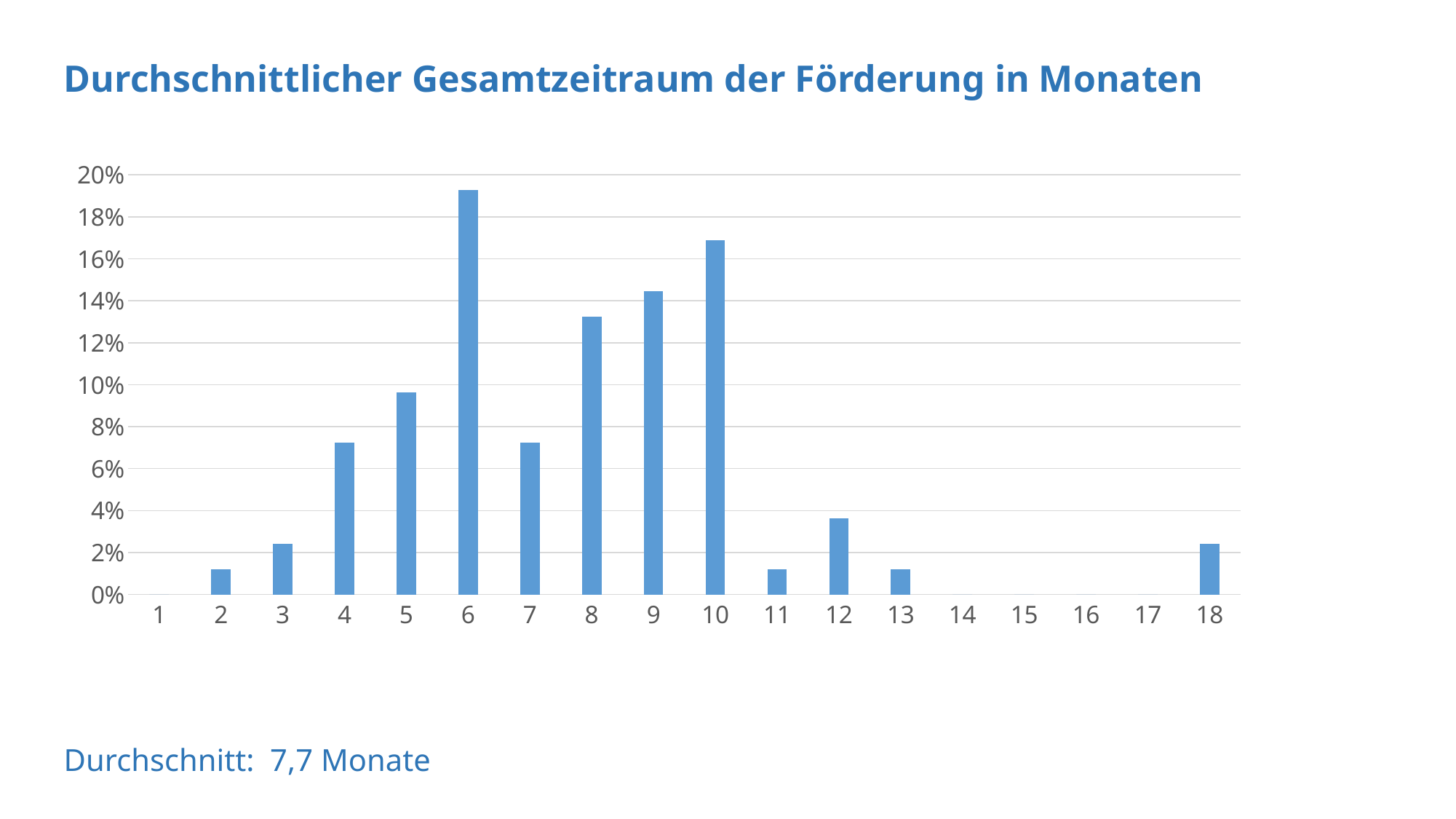
What kind of chart is shown on the slide? bar chart Is the value for 10 greater or less than 16%? greater Which has the larger value, 8 or 9? 9 Which month value on the x axis has the highest bar? 6 Is the value for 6 greater or less than 18%? greater Is the value for 5 greater or less than 10%? less Which has the larger value, 2 or 3? 3 Which has the larger value, 6 or 10? 6 How many categories are shown on the x axis? 18 What is the title of the chart? Durchschnittlicher Gesamtzeitraum der Förderung in Monaten What average (Durchschnitt) is stated below the chart? 7,7 Monate